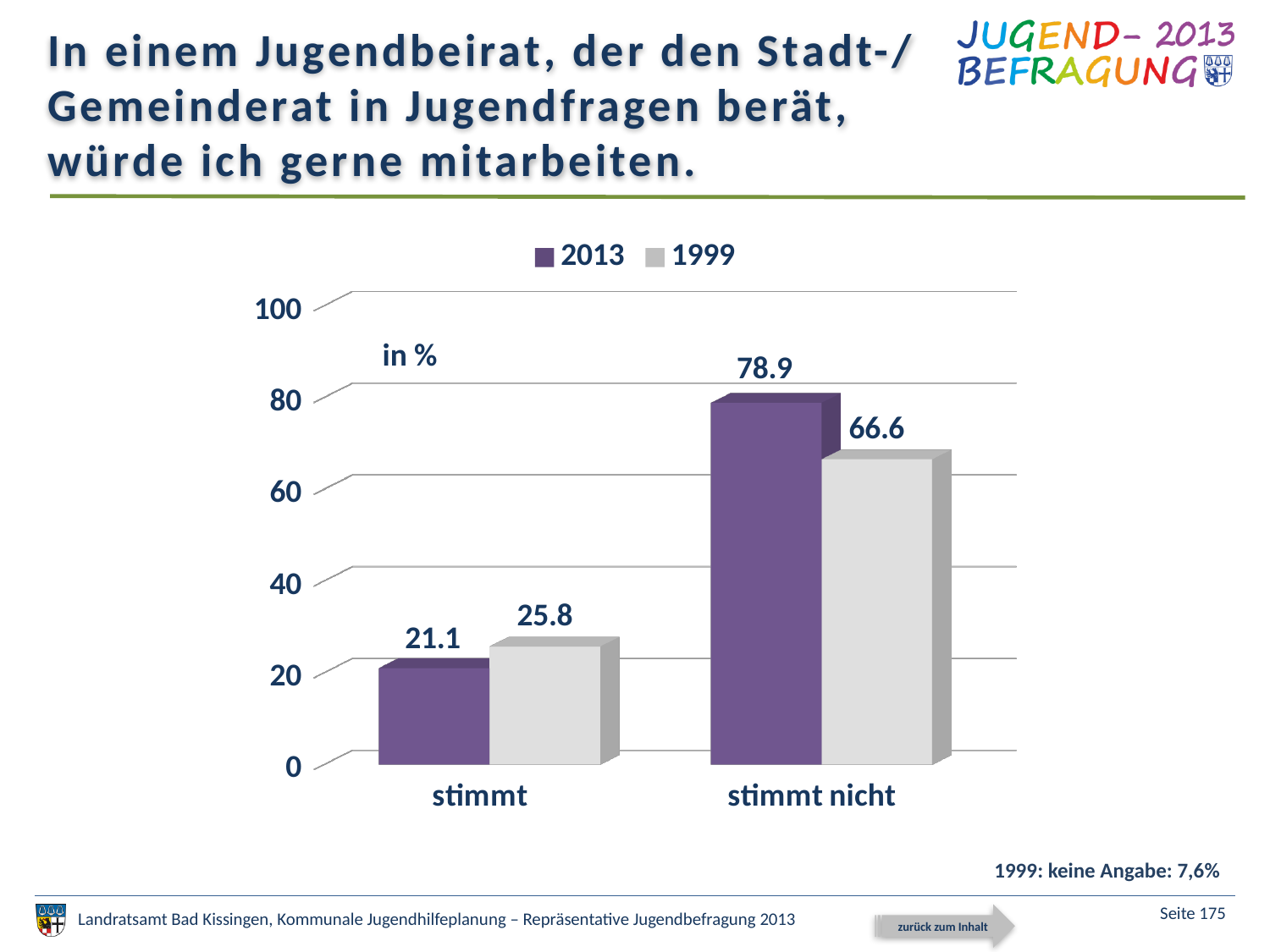
What is the value for "stimmt" in the 1999 series? 25.8 Which category has the highest value in the 2013 series? stimmt nicht How many series does the legend list? 2 Which category has the lowest value in the 1999 series? stimmt What is the value for "stimmt nicht" in the 1999 series? 66.6 What is the difference between the 2013 and 1999 values for "stimmt nicht"? 12.3 What kind of chart is shown on the slide? bar chart Is the 2013 value for "stimmt nicht" greater or less than 60? greater What is the value for "stimmt" in the 2013 series? 21.1 Which is larger for "stimmt": the 2013 value or the 1999 value? 1999 How many categories are shown on the x axis? 2 What is the value for "stimmt nicht" in the 2013 series? 78.9